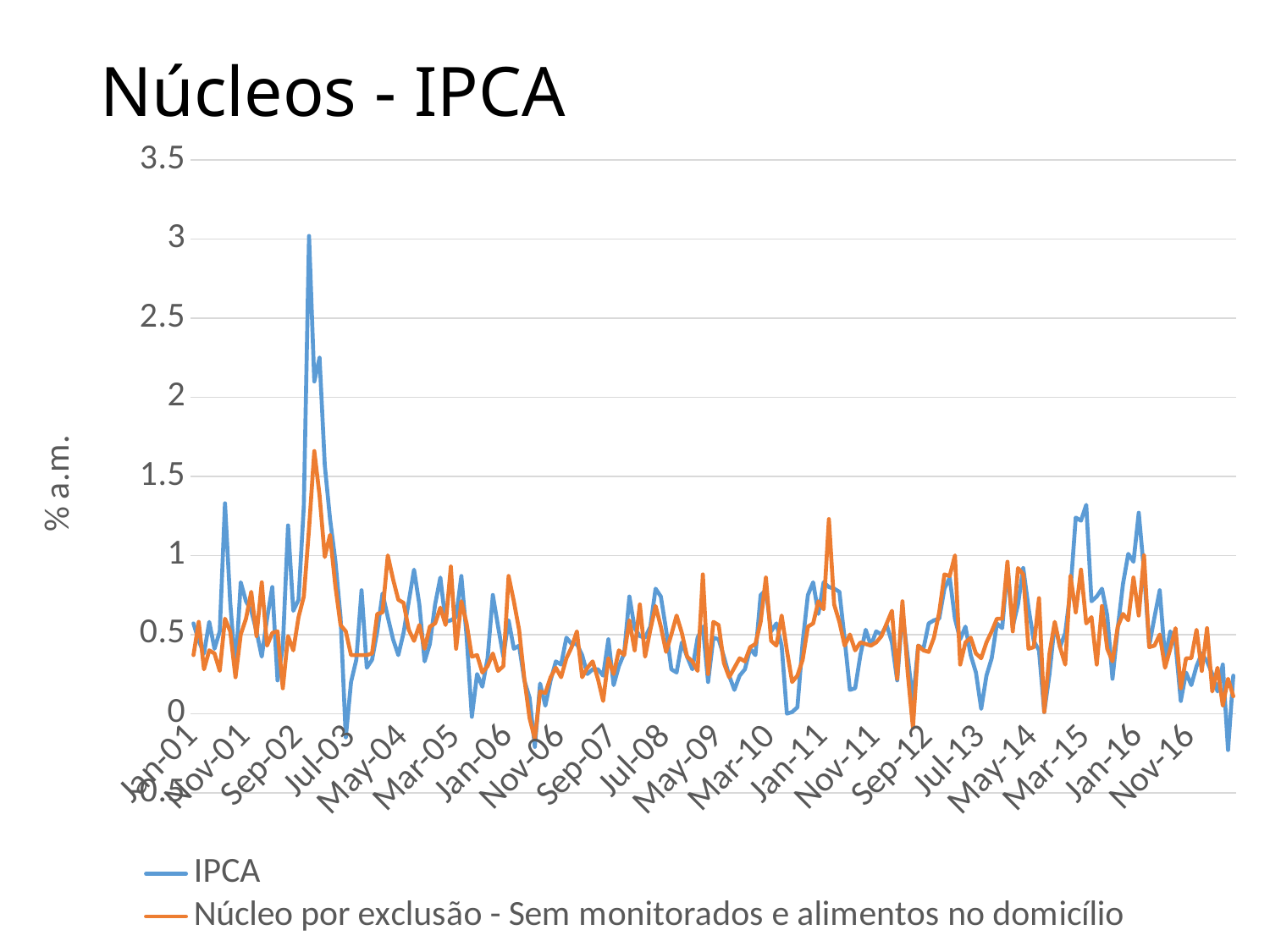
How many series does the legend list? 2 Is the peak value of the Núcleo por exclusão series greater or less than 1? greater What is the title of the chart? Núcleos - IPCA Which series has the higher peak around early 2003, IPCA or Núcleo por exclusão? IPCA What is the last date label shown on the horizontal axis? Nov-16 What is the label on the vertical axis? % a.m. Is the peak value of the Núcleo por exclusão series greater or less than 2? less Is the lowest value of the IPCA series greater or less than 0? less What kind of chart is shown on the slide? line chart What is the first date label shown on the horizontal axis? Jan-01 Which series reaches the highest value on the chart? IPCA